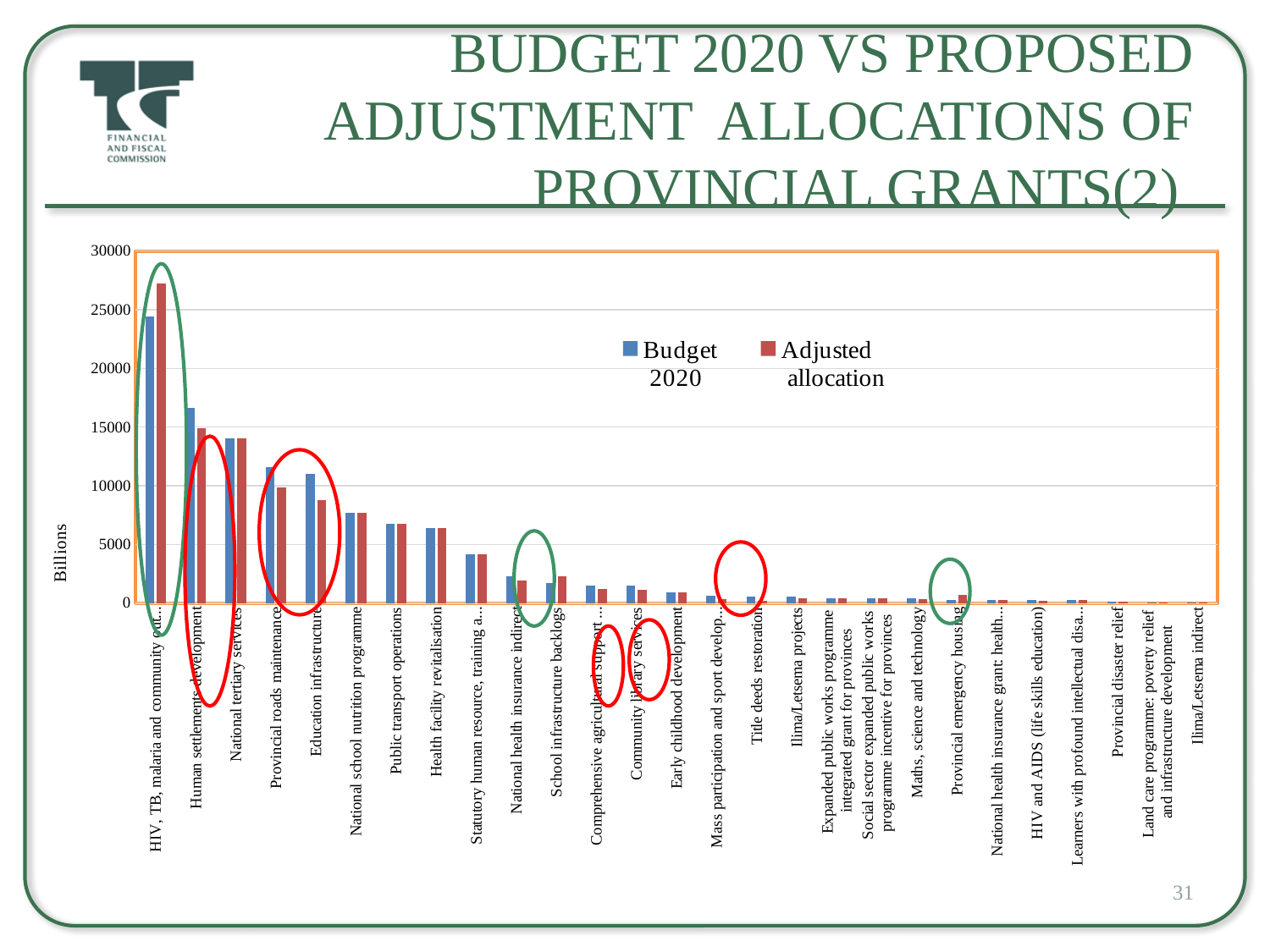
How many grant categories are plotted along the x axis? 27 Do the Budget 2020 values generally rise or fall moving from left to right along the x axis? fall Is the Budget 2020 value for Statutory human resource, training a... greater or less than 5000? less How many series does the legend list? 2 Is the Budget 2020 value for HIV, TB, malaria and community out... greater or less than 20000? greater For Human settlements development, which is larger: the Budget 2020 value or the Adjusted allocation value? Budget 2020 Is the Budget 2020 value for Education infrastructure greater or less than 10000? greater What are the two series named in the legend? Budget 2020 and Adjusted allocation What kind of chart is shown on the slide? bar chart Which category has the highest Adjusted allocation value? HIV, TB, malaria and community out... Which category has the highest Budget 2020 value? HIV, TB, malaria and community out...